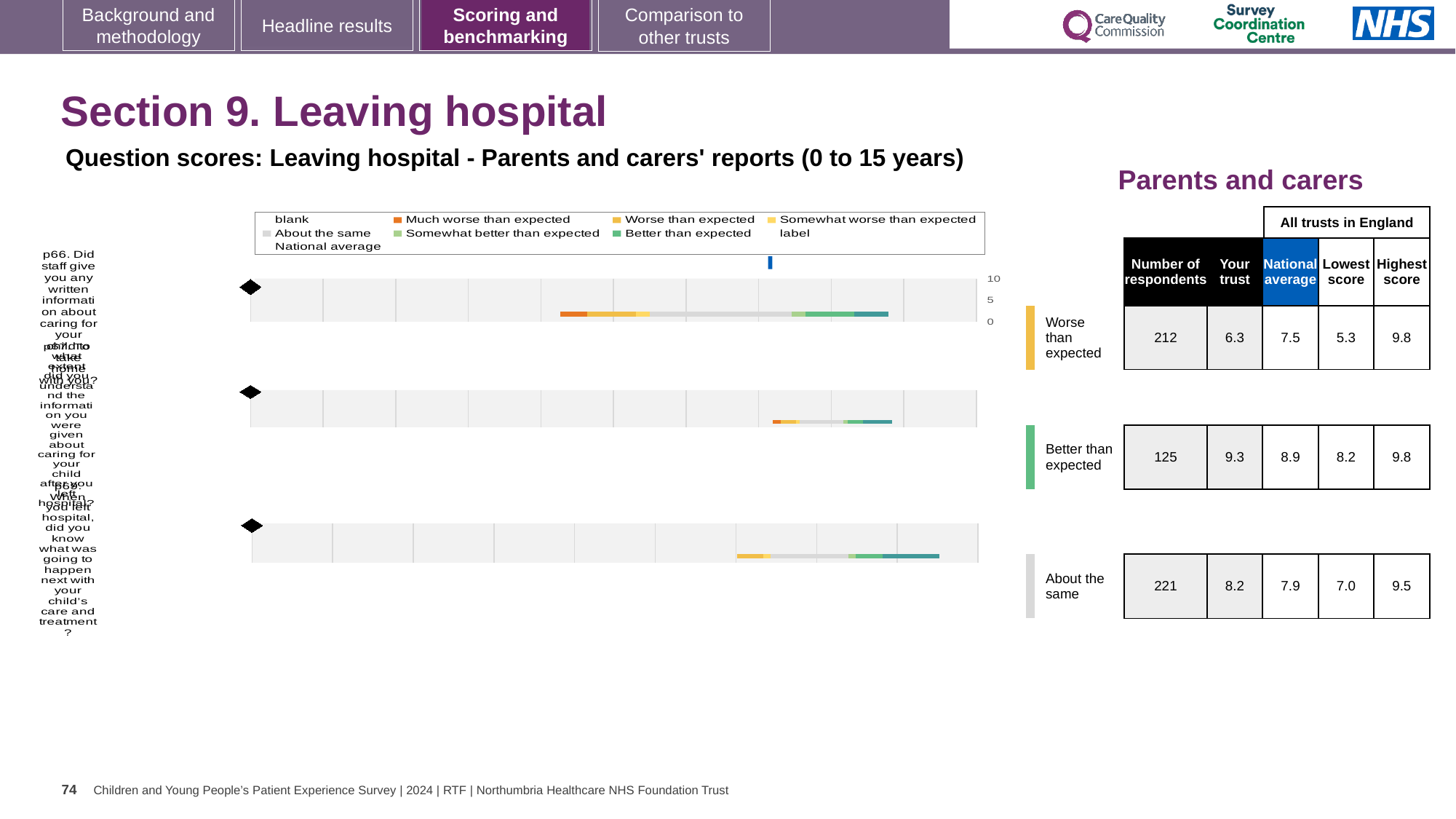
In the chart legend, what colour represents 'About the same'? grey In the table on the right, which row has the lowest 'Your trust' score? Worse than expected How many question bars are plotted in the chart? 3 In the chart legend, what colour represents 'Much worse than expected'? orange How many entries does the chart legend list? 9 What kind of chart is shown on the slide? bar chart In the table on the right, which row has the highest number of respondents? About the same In the table on the right, what is the difference between the 'Your trust' score and the national average for the 'Better than expected' row? 0.4 In the table on the right, what is the number of respondents for the 'Worse than expected' row? 212 In the table on the right, what is the lowest score for the 'Worse than expected' row? 5.3 In the table on the right, what is the national average for the 'About the same' row? 7.9 In the table on the right, what is the 'Your trust' score for the 'Better than expected' row? 9.3